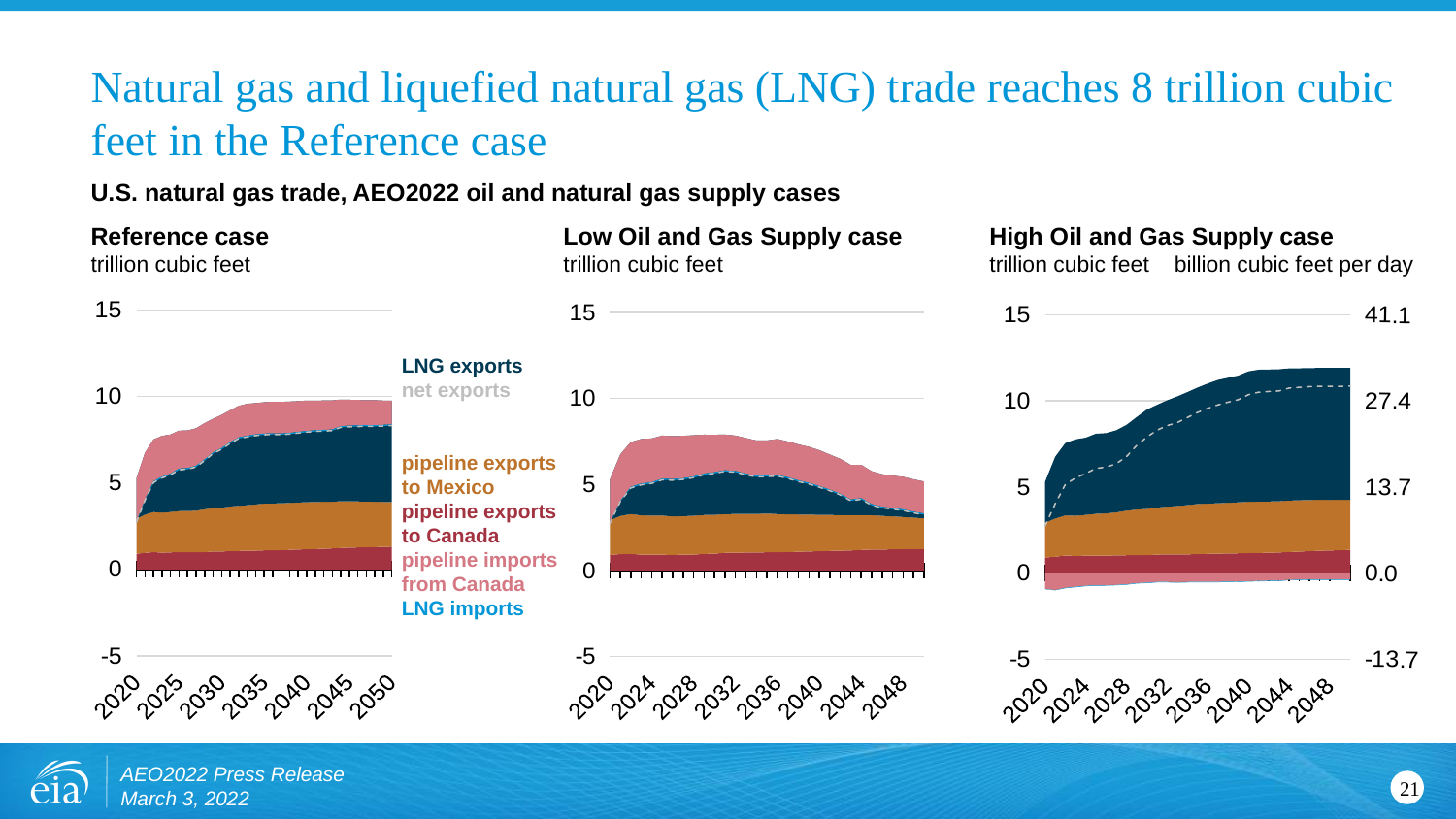
How many series does the legend next to the Reference case chart list? 6 In the High Oil and Gas Supply case chart, what right-axis value corresponds to 15 trillion cubic feet on the left axis? 41.1 In the High Oil and Gas Supply case chart, what right-axis value corresponds to 10 trillion cubic feet on the left axis? 27.4 In the Reference case chart, what unit is shown under the chart title? trillion cubic feet In the Low Oil and Gas Supply case chart, is the total of the stacked exports in 2048 greater or less than 10 trillion cubic feet? less In the Reference case chart, is the total of the stacked exports in 2050 greater or less than 5 trillion cubic feet? greater How many charts are shown on the slide? 3 In the High Oil and Gas Supply case chart, is the total of the stacked exports in 2048 greater or less than 10 trillion cubic feet? greater What kind of chart is used for the Reference case? stacked area chart In the High Oil and Gas Supply case chart, what unit is used for the right-hand axis? billion cubic feet per day Which of the three cases shows the highest total exports in 2048? High Oil and Gas Supply case In the Low Oil and Gas Supply case chart, do total exports rise or fall between 2032 and 2048? fall